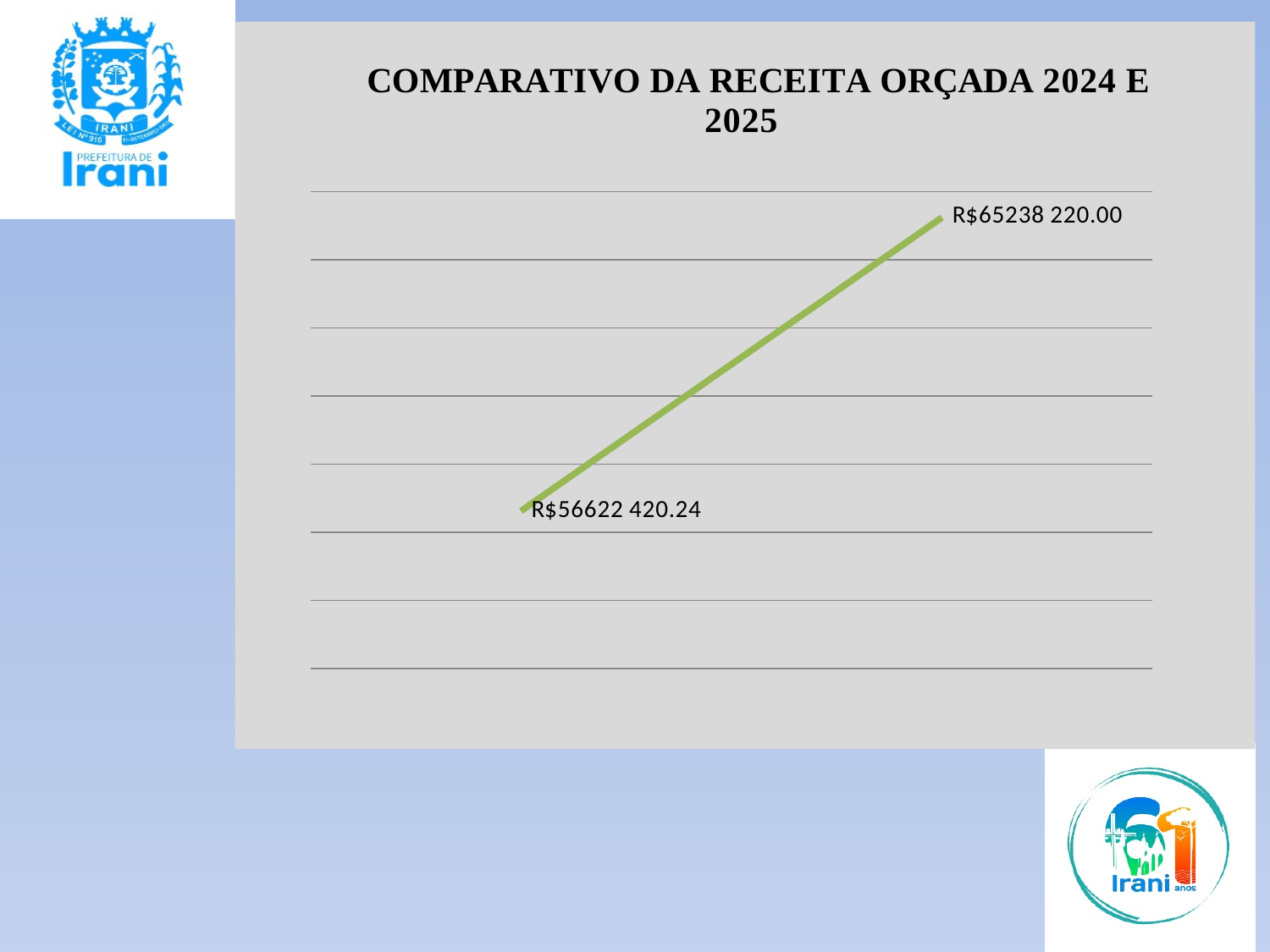
Is R$65238 220.00 larger or smaller than R$56622 420.24? larger Which point has the lower value, the left one or the right one? the left one What kind of chart is shown on the slide? line chart What is the difference between the two plotted values? R$8615 799.76 Which point has the higher value, the left one or the right one? the right one What is the value of the second (right) point on the line? R$65238 220.00 Does the line rise or fall from left to right? rise How many data points are plotted on the line? 2 What is the value of the first (left) point on the line? R$56622 420.24 What colour is the plotted line? green What is the title of the chart? COMPARATIVO DA RECEITA ORÇADA 2024 E 2025